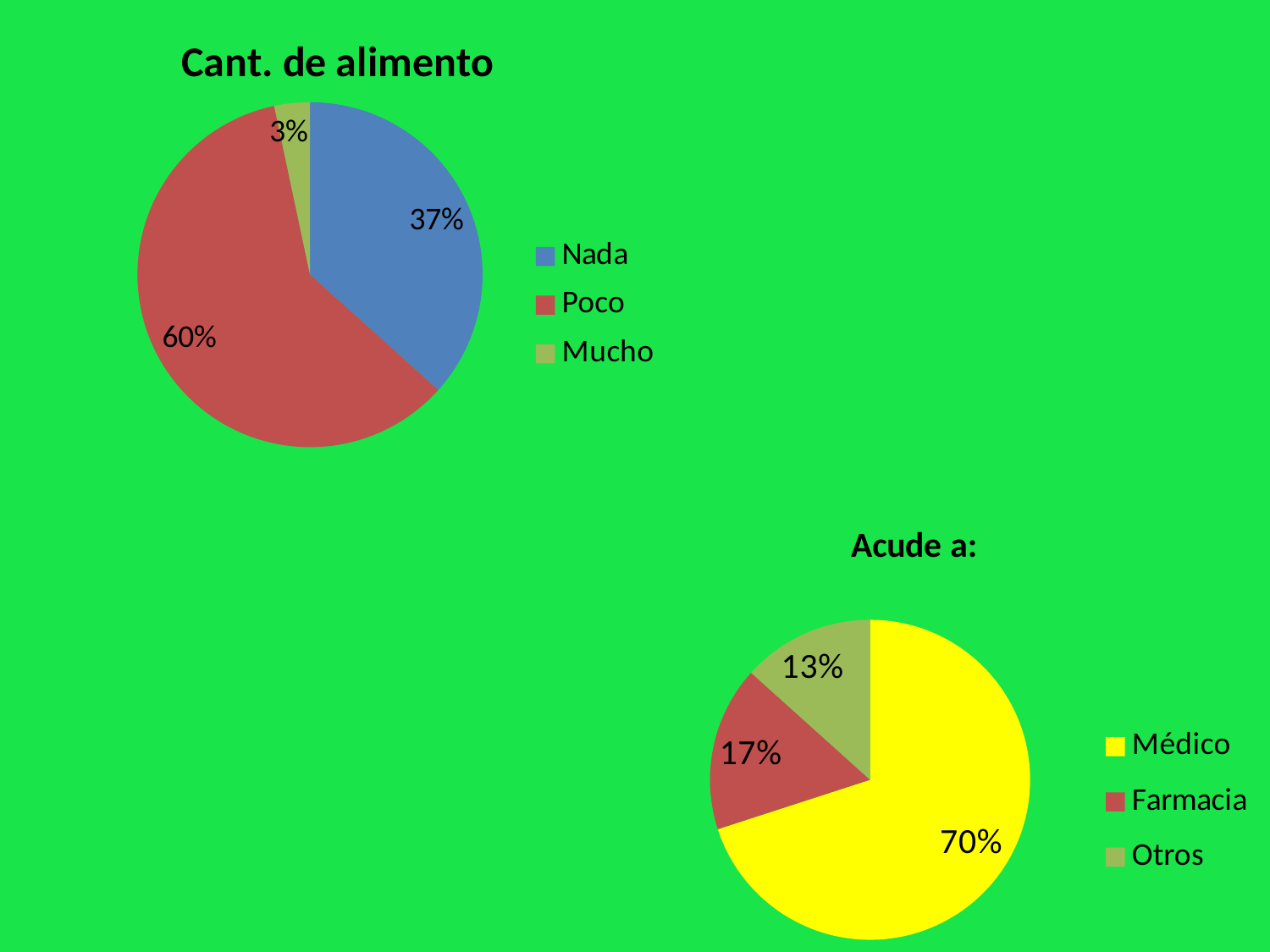
In the 'Cant. de alimento' chart, which category has the smallest slice? Mucho What kind of chart is the 'Cant. de alimento' chart? Pie chart In the 'Cant. de alimento' chart, which category has the largest slice? Poco In the 'Cant. de alimento' chart, what percentage is shown for Nada? 37% In the 'Acude a:' chart, what colour is the Médico slice? Yellow In the 'Acude a:' chart, what is the difference in percentage points between Médico and Farmacia? 53 In the 'Acude a:' chart, which is larger, Farmacia or Otros? Farmacia In the 'Acude a:' chart, what percentage is shown for Médico? 70% In the 'Cant. de alimento' chart, what is the difference in percentage points between Poco and Nada? 23 In the 'Cant. de alimento' chart, what percentage is shown for Poco? 60% In the 'Acude a:' chart, what percentage is shown for Otros? 13% How many categories does the legend of the 'Acude a:' chart list? 3